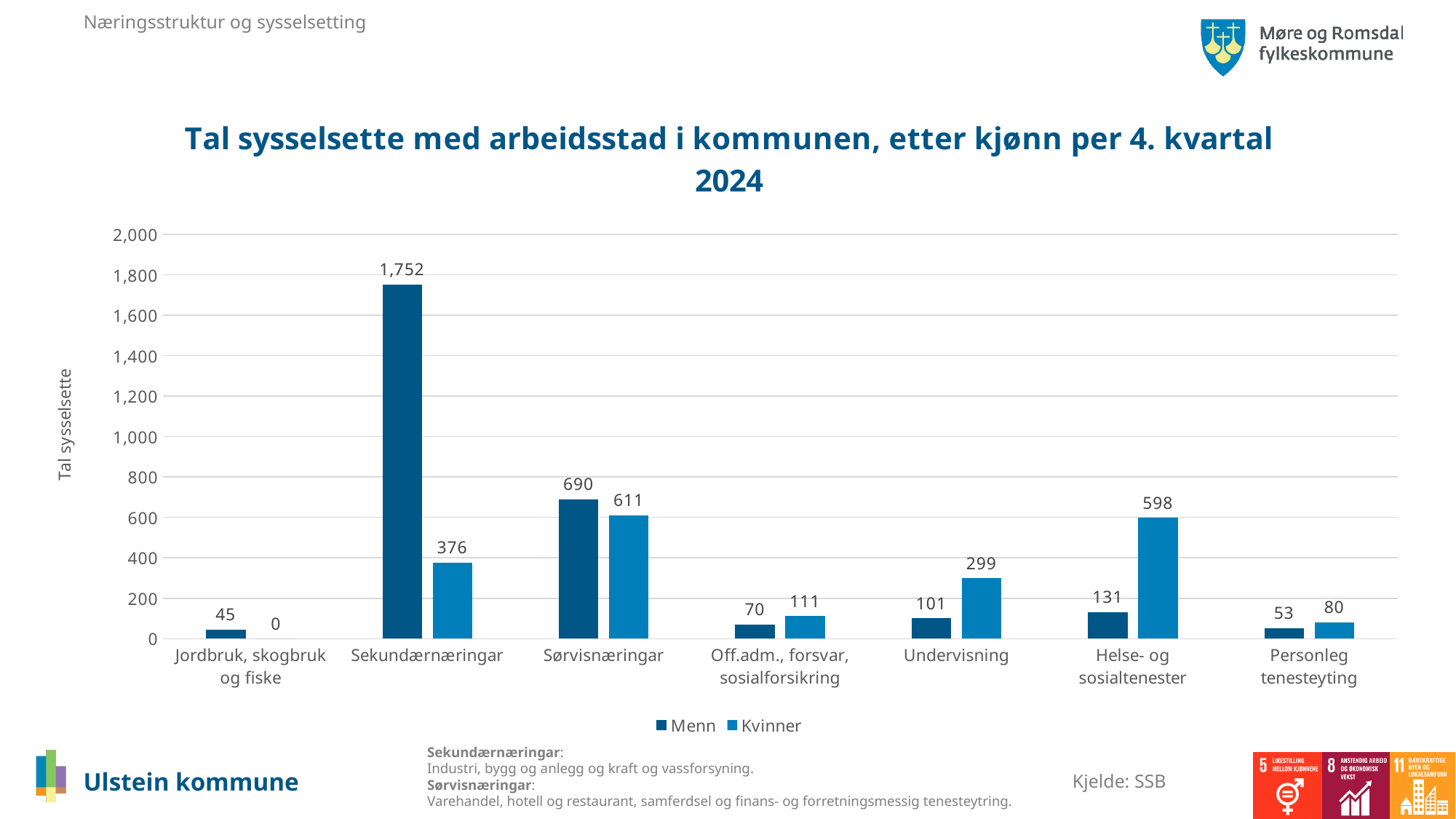
What is the value for Kvinner in Jordbruk, skogbruk og fiske? 0 Which category has the highest value for Kvinner? Sørvisnæringar What kind of chart is shown? bar chart What is the label of the y axis? Tal sysselsette Which is larger in Undervisning, Menn or Kvinner? Kvinner What is the difference between Menn and Kvinner in Sørvisnæringar? 79 What is the value for Kvinner in Helse- og sosialtenester? 598 Which category has the lowest value for Menn? Jordbruk, skogbruk og fiske Is the value for Kvinner in Sekundærnæringar greater or less than 400? less What is the value for Menn in Sekundærnæringar? 1,752 How many categories are shown on the x axis? 7 How many series does the legend list? 2